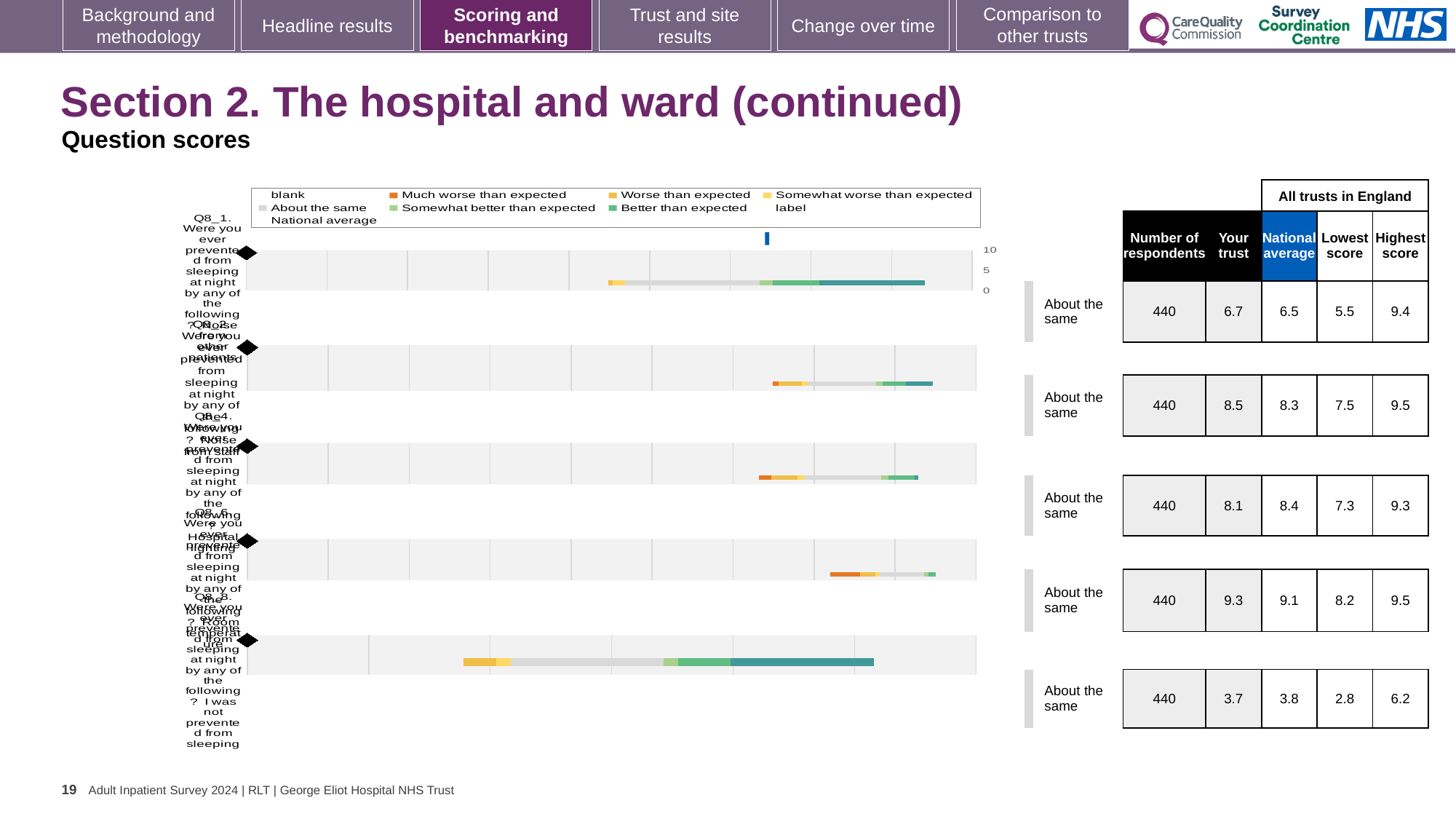
For the first row (Q8_1), what is the difference between the highest score and the lowest score across all trusts in England? 3.9 Which row has the lowest 'Your trust' score? The fifth row (Q8_8), 3.7 For the second row (Q8_2), which is larger: the 'Your trust' score or the national average? Your trust (8.5) What kind of chart is shown on the slide? bar chart Which row has the highest 'Your trust' score? The fourth row (Q8_6), 9.3 What is the maximum value shown on the chart's score axis? 10 How many respondents are listed for each question row? 440 What is the national average for the fifth (bottom) row (Q8_8)? 3.8 For the fourth row (Q8_6), what is the difference between the 'Your trust' score and the national average? 0.2 What benchmark category label is shown next to every row of the chart? About the same What is the 'Your trust' score for the first row (Q8_1)? 6.7 How many question rows (bars) does the chart show? 5